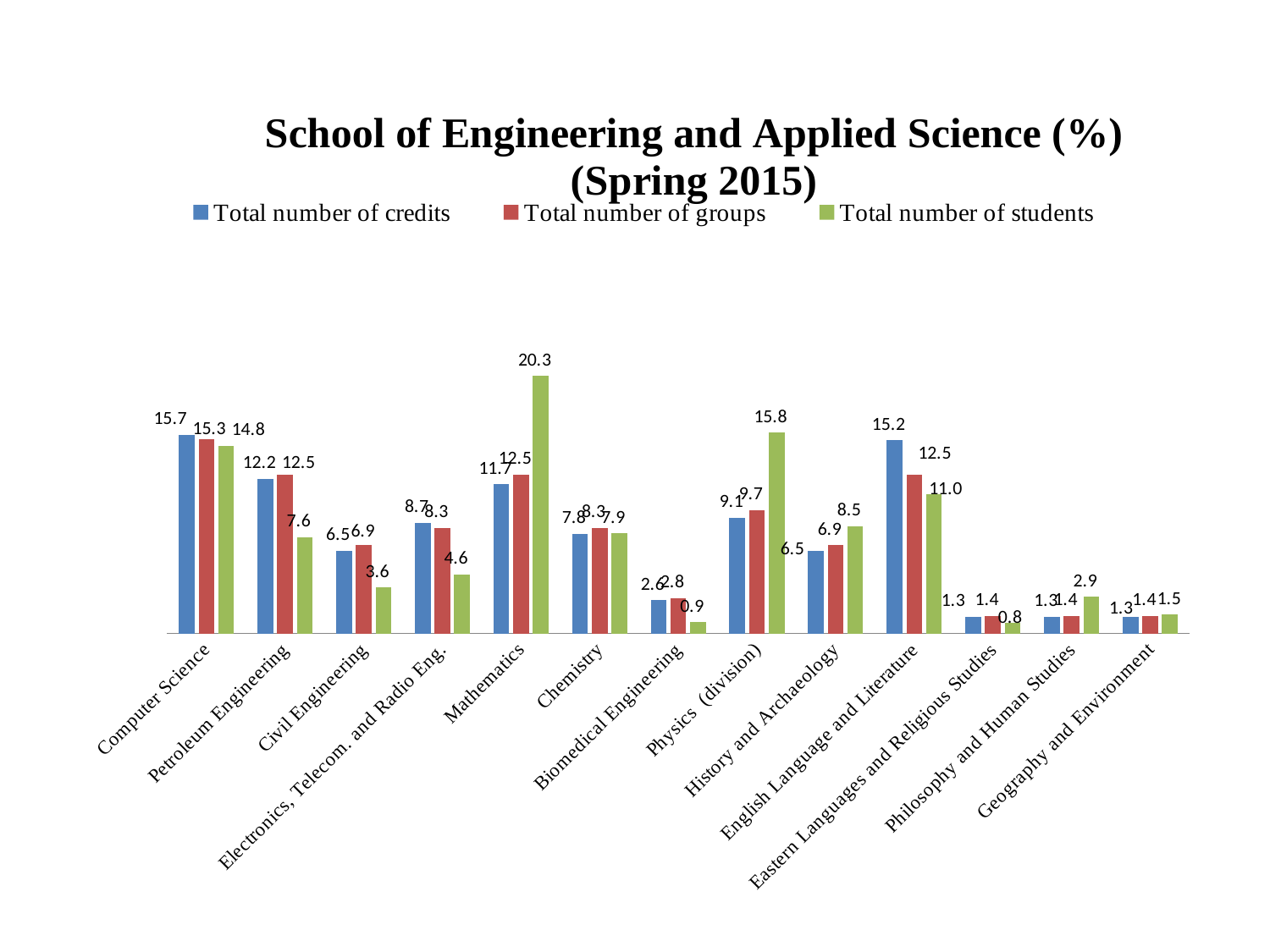
What is the title of the chart? School of Engineering and Applied Science (%) (Spring 2015) Which category has the lowest Total number of students value? Eastern Languages and Religious Studies What is the Total number of credits value for Computer Science? 15.7 How many series does the legend list? 3 What is the Total number of students value for Mathematics? 20.3 What is the Total number of groups value for Physics (division)? 9.7 Which is larger for English Language and Literature: Total number of credits or Total number of groups? Total number of credits Which category has the highest Total number of students value? Mathematics What kind of chart is shown on the slide? Bar chart How many categories are shown on the x axis? 13 What is the Total number of students value for Eastern Languages and Religious Studies? 0.8 What is the difference between the Total number of students values for Mathematics and Physics (division)? 4.5